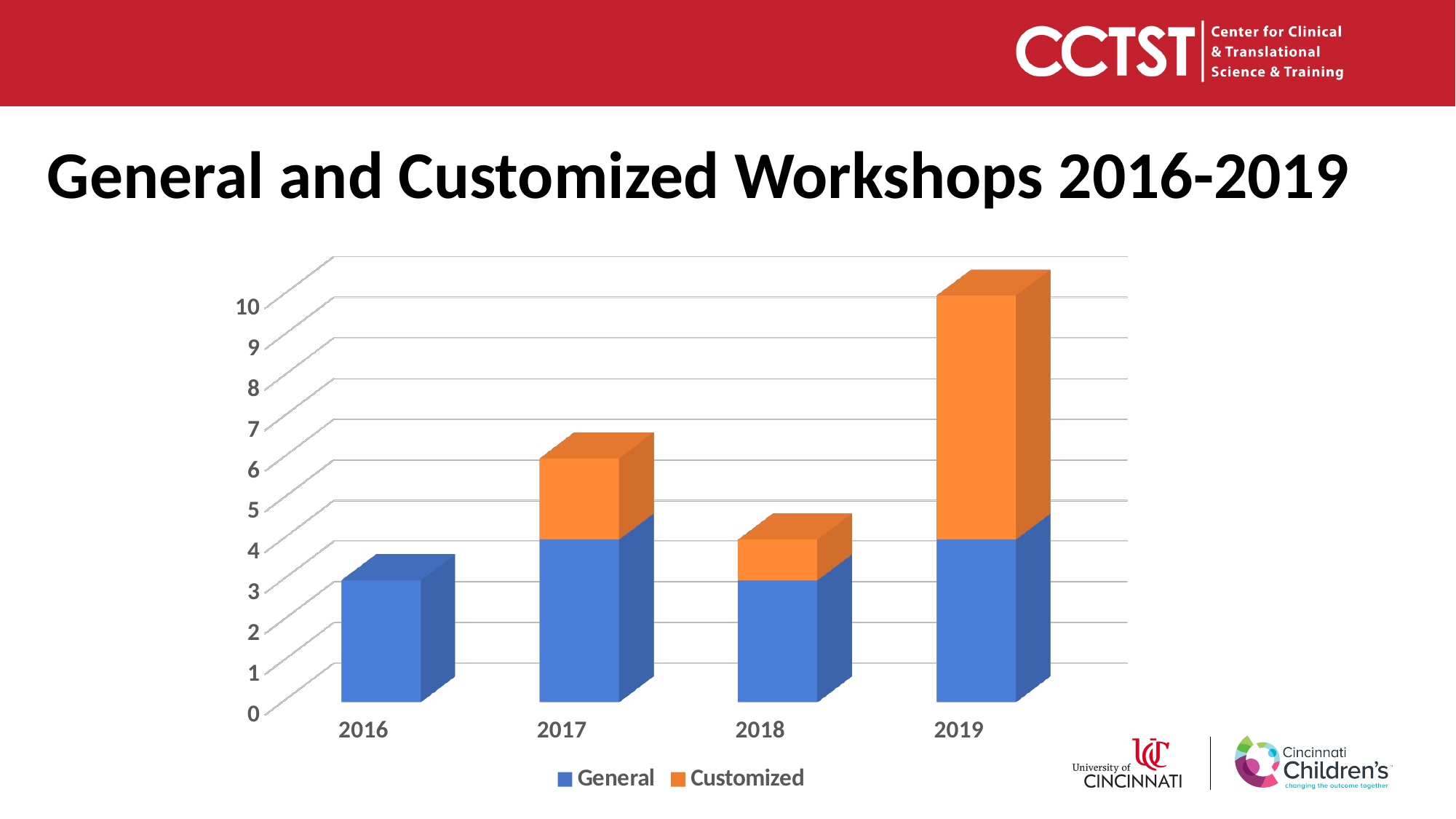
Which year has the highest total number of workshops? 2019 What is the title of the chart on the slide? General and Customized Workshops 2016-2019 How many years are shown on the x axis of the chart? 4 What kind of chart is shown on the slide? bar chart Is the total for 2019 greater or less than 8? greater Which year has the lowest total number of workshops? 2016 How many series does the chart legend list? 2 Which year has the larger total, 2017 or 2018? 2017 Which year has the larger Customized segment, 2017 or 2019? 2019 Which colour represents the Customized series in the chart? orange Is the total for 2017 greater or less than 5? greater Is the total for 2016 greater or less than 4? less